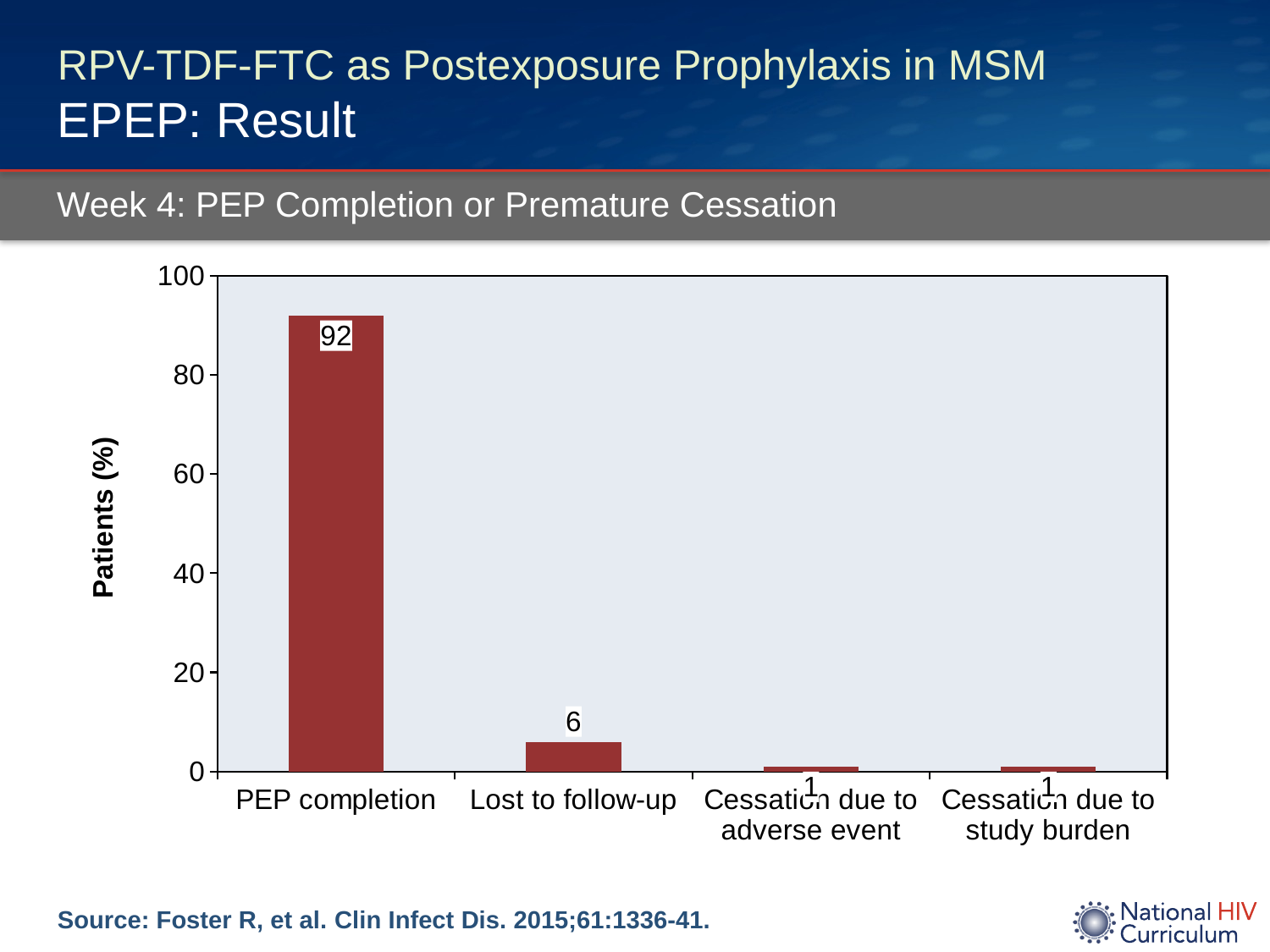
What is the value for PEP completion? 92 What is the label of the y axis? Patients (%) Is the value for PEP completion greater or less than 80? greater What is the value for Lost to follow-up? 6 What is the value for Cessation due to adverse event? 1 What kind of chart is shown on the slide? bar chart Which is larger, the value for Lost to follow-up or the value for Cessation due to adverse event? Lost to follow-up Which category has the highest value? PEP completion What is the difference between the values for PEP completion and Lost to follow-up? 86 What is the value for Cessation due to study burden? 1 How many categories are shown on the x axis? 4 What is the title shown above the chart? Week 4: PEP Completion or Premature Cessation